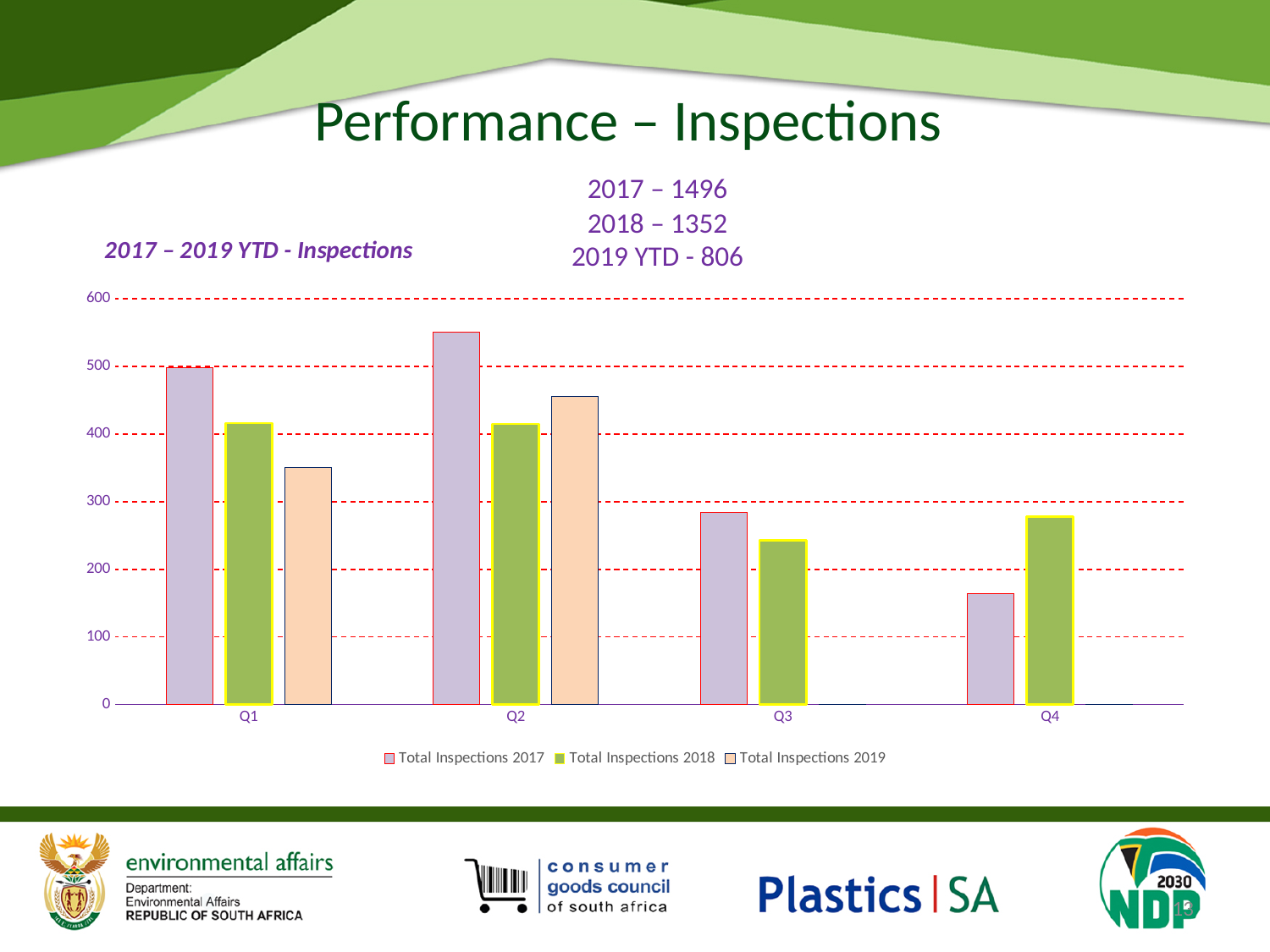
In Q4, which is larger: Total Inspections 2017 or Total Inspections 2018? Total Inspections 2018 Is the Total Inspections 2017 value for Q2 greater or less than 500? greater In which quarter is the Total Inspections 2017 bar the highest? Q2 How many quarters are shown on the x axis? 4 Is the Total Inspections 2019 value for Q1 greater or less than 400? less How many series does the legend list? 3 In which quarter is the Total Inspections 2018 bar the lowest? Q3 Is the Total Inspections 2017 value for Q4 greater or less than 200? less What kind of chart is shown on the slide? bar chart In which quarter is the Total Inspections 2017 bar the lowest? Q4 What is the title of the chart? 2017 – 2019 YTD - Inspections In Q2, which is larger: Total Inspections 2018 or Total Inspections 2019? Total Inspections 2019